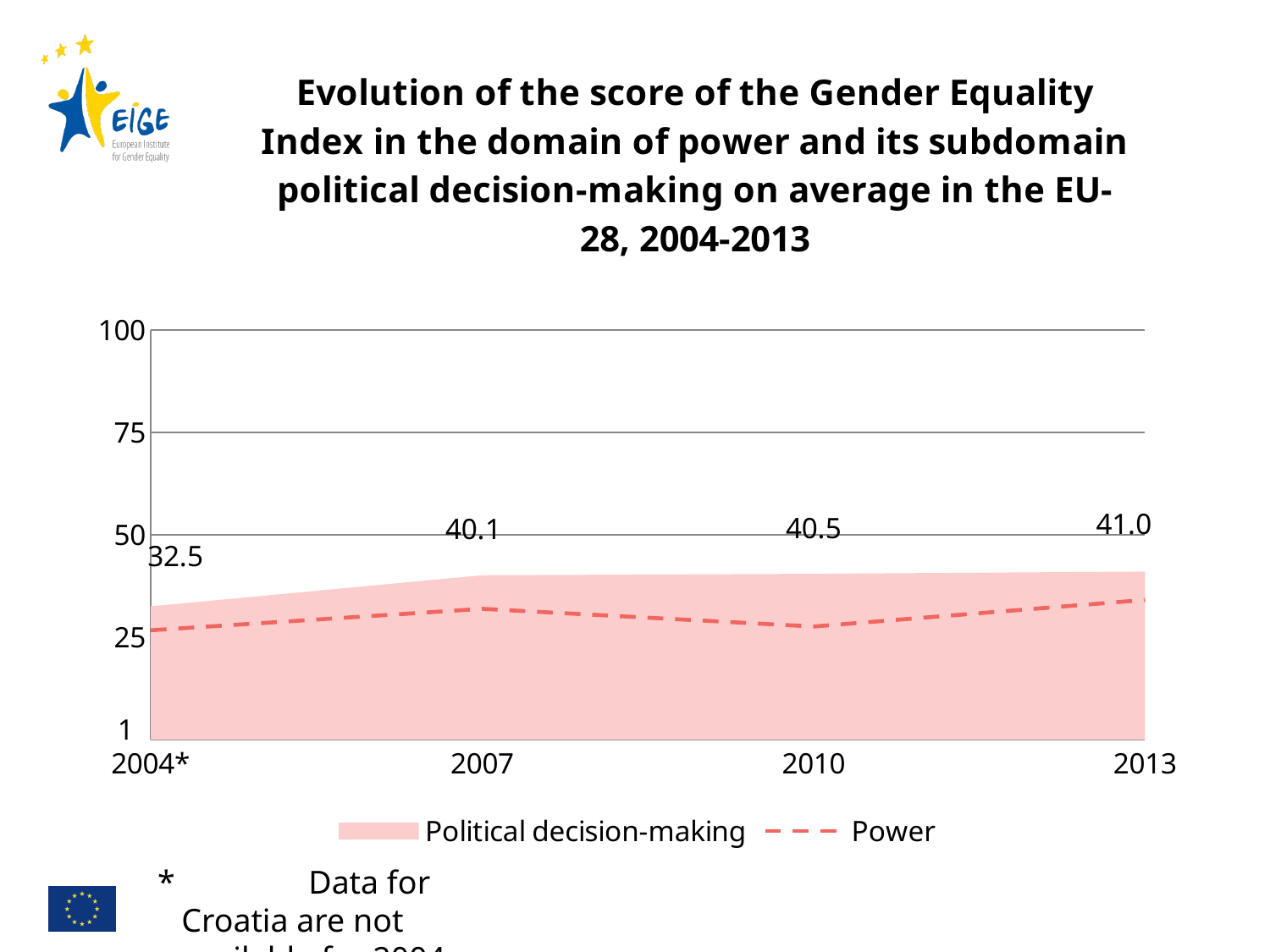
Does the Political decision-making score rise or fall from 2004* to 2013? rise What is the Political decision-making score in 2007? 40.1 What is the difference between the Political decision-making score in 2013 and in 2004*? 8.5 Which is larger, the Political decision-making score in 2010 or in 2007? 2010 How many series does the legend list? 2 In which year is the Political decision-making score lowest? 2004* Is the value for Power in 2007 greater or less than 25? greater How many years are shown on the x axis? 4 Is the value for Power in 2013 greater or less than 50? less What is the Political decision-making score in 2004*? 32.5 In which year is the Political decision-making score highest? 2013 What is the Political decision-making score in 2013? 41.0